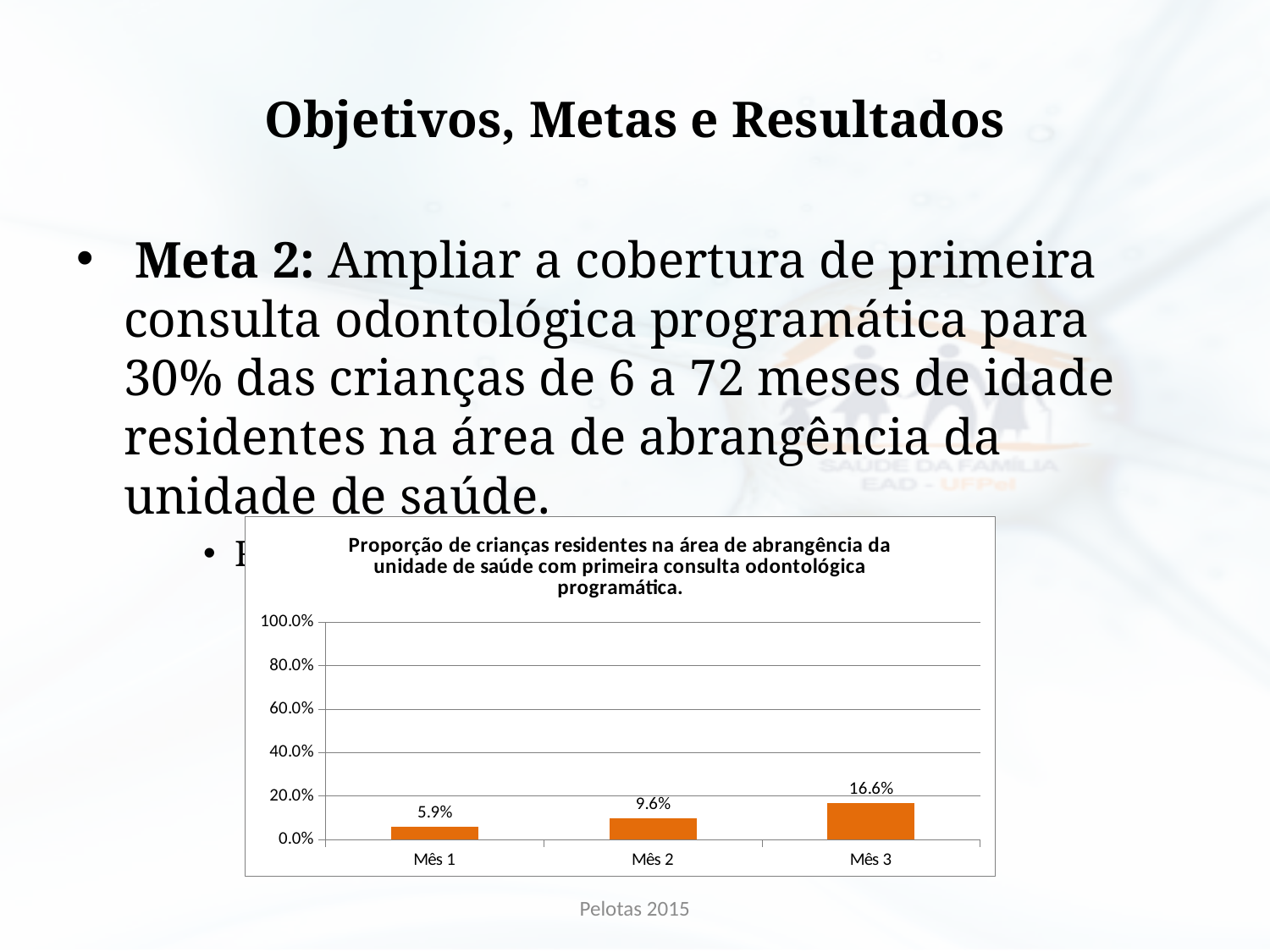
What is the value for Mês 1? 5.9% What is the difference between the values for Mês 3 and Mês 1? 10.7% What is the value for Mês 2? 9.6% Is the value for Mês 3 greater or less than 20.0%? less What is the difference between the values for Mês 2 and Mês 1? 3.7% Which is larger, the value for Mês 2 or the value for Mês 3? Mês 3 What is the value for Mês 3? 16.6% How many months are shown on the x axis? 3 Do the values rise or fall from Mês 1 to Mês 3? rise Which month has the lowest value? Mês 1 What kind of chart is shown? bar chart Which month has the highest value? Mês 3